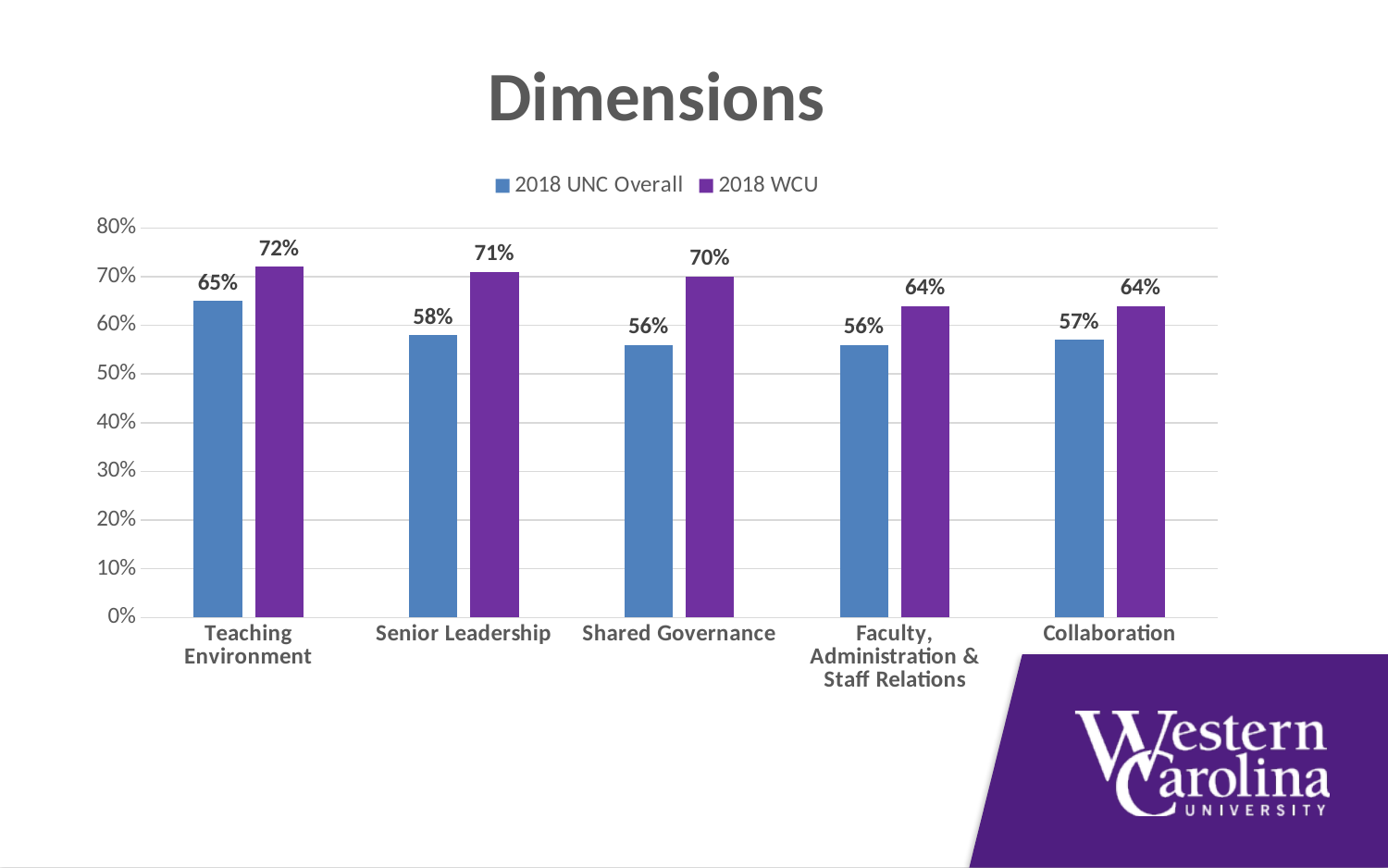
What is the 2018 WCU value for Shared Governance? 70% What is the title of the chart? Dimensions What is the 2018 UNC Overall value for Senior Leadership? 58% Which category has the lowest 2018 UNC Overall value? Shared Governance and Faculty, Administration & Staff Relations (both 56%) What is the difference between the 2018 WCU and 2018 UNC Overall values for Shared Governance? 14 percentage points Which category has the highest 2018 WCU value? Teaching Environment What is the 2018 UNC Overall value for Collaboration? 57% What kind of chart is shown on the slide? Bar chart What is the 2018 WCU value for Teaching Environment? 72% How many categories are shown on the x axis? 5 Which is larger for Faculty, Administration & Staff Relations: the 2018 UNC Overall value or the 2018 WCU value? 2018 WCU How many series does the legend list? 2